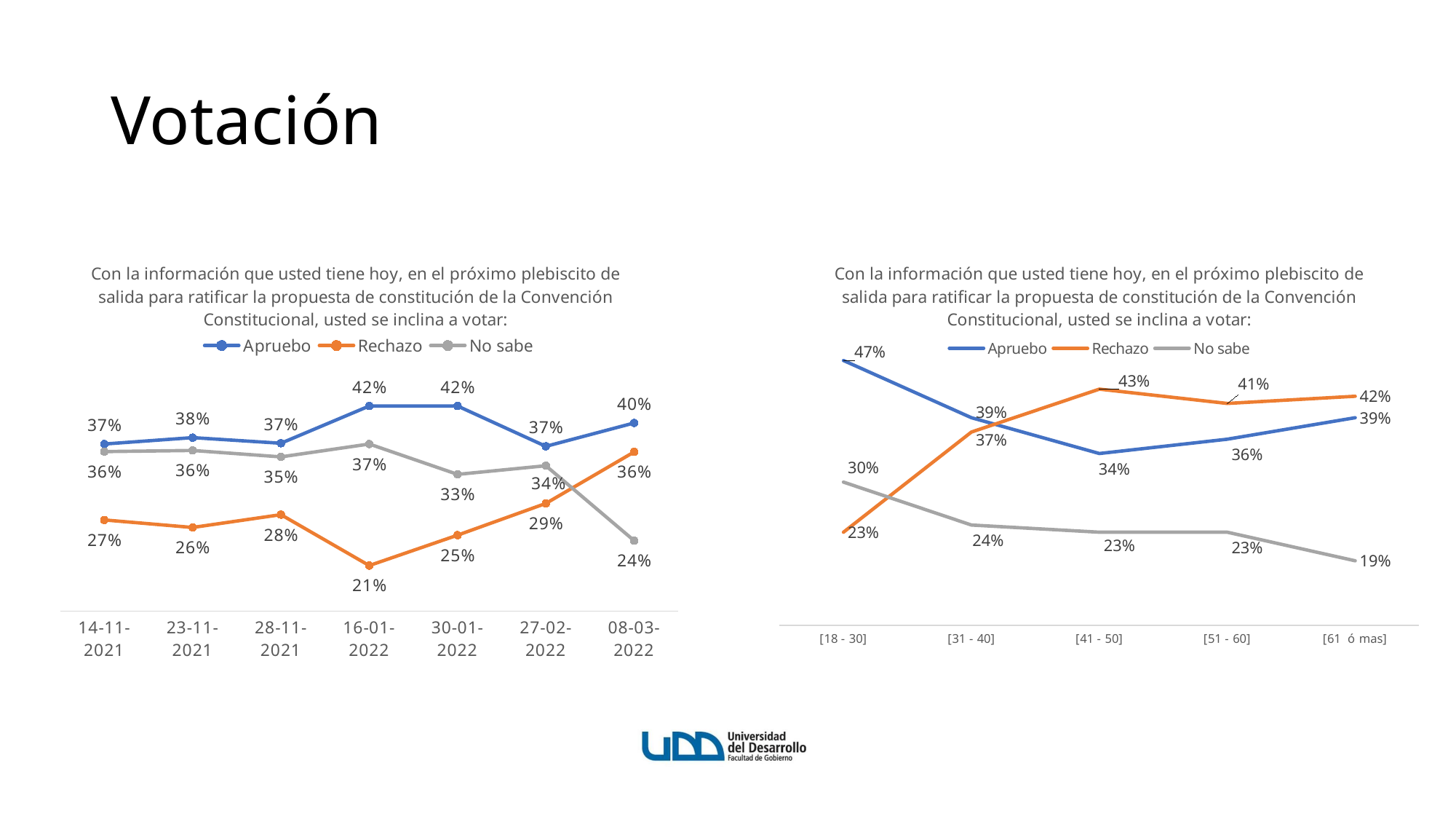
In the right chart (by age group), what is the difference between Apruebo and Rechazo in the [18 - 30] group? 24 percentage points In the left chart (by date), what is the difference between Apruebo and Rechazo on 16-01-2022? 21 percentage points In the left chart (by date), how many dates are shown on the x axis? 7 How many series does the legend of the right chart (by age group) list? 3 In the right chart (by age group), which age group has the highest Apruebo value? [18 - 30] In the left chart (by date), what is the value for Rechazo on 08-03-2022? 36% In the right chart (by age group), which is larger in the [61 ó mas] group, Apruebo or Rechazo? Rechazo What type of chart is the left chart (by date)? Line chart In the left chart (by date), does No sabe rise or fall between 27-02-2022 and 08-03-2022? Fall In the left chart (by date), what is the value for Apruebo on 16-01-2022? 42% In the left chart (by date), on which date is Rechazo at its lowest? 16-01-2022 In the right chart (by age group), what is the value for Rechazo in the [41 - 50] group? 43%